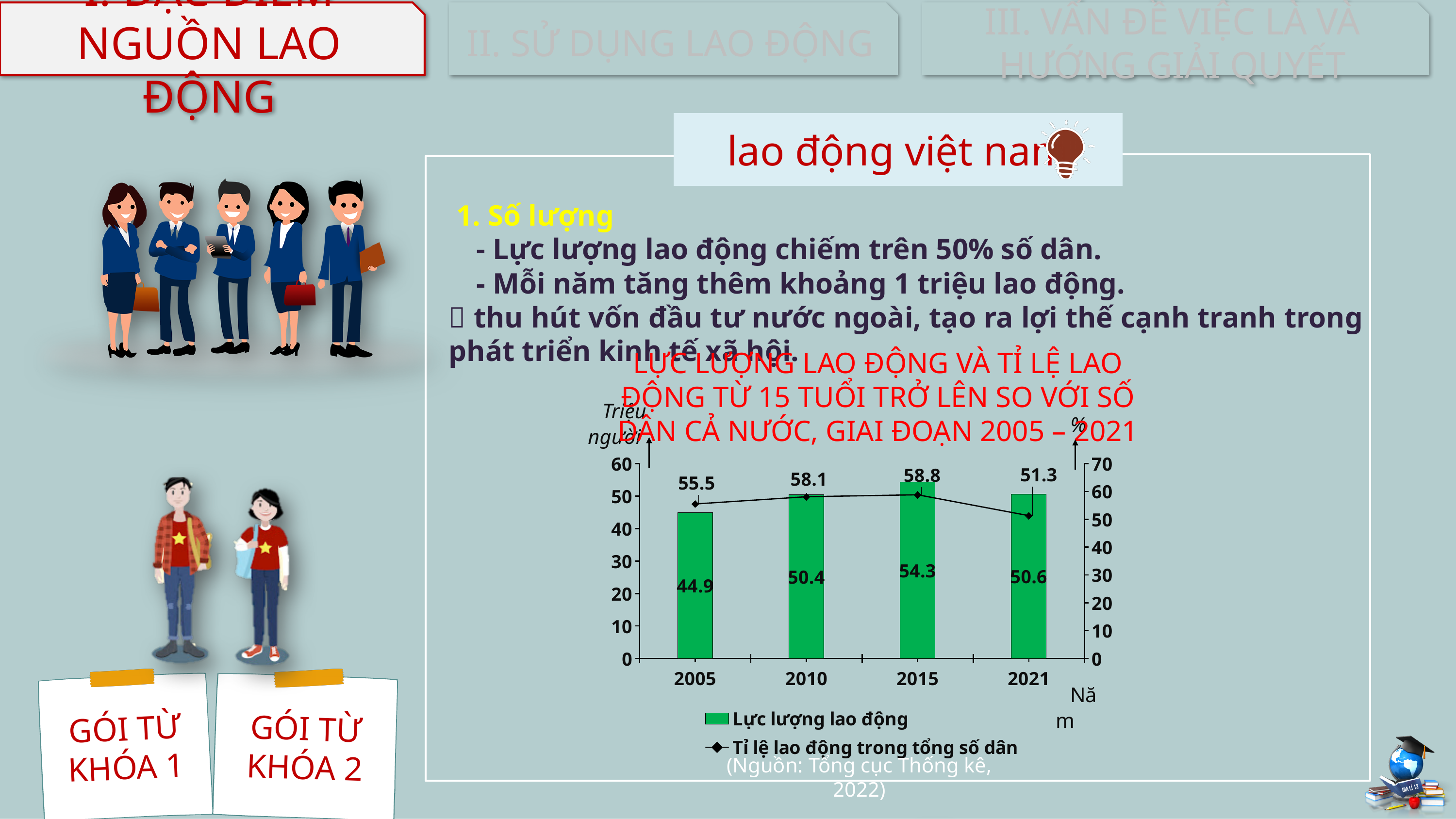
How many years are shown on the x axis of the chart? 4 What is the value of Tỉ lệ lao động trong tổng số dân in 2005? 55.5 In which year is Tỉ lệ lao động trong tổng số dân lowest? 2021 What is the value of Lực lượng lao động in 2021? 50.6 What is the value of Lực lượng lao động in 2015? 54.3 In which year is Lực lượng lao động highest? 2015 Which year has a larger Lực lượng lao động, 2010 or 2021? 2021 What is the difference between Tỉ lệ lao động trong tổng số dân in 2015 and in 2021? 7.5 What is the difference between Lực lượng lao động in 2015 and in 2005? 9.4 What colour are the bars for Lực lượng lao động? green How many series does the chart legend list? 2 Does Tỉ lệ lao động trong tổng số dân rise or fall from 2005 to 2015? rise